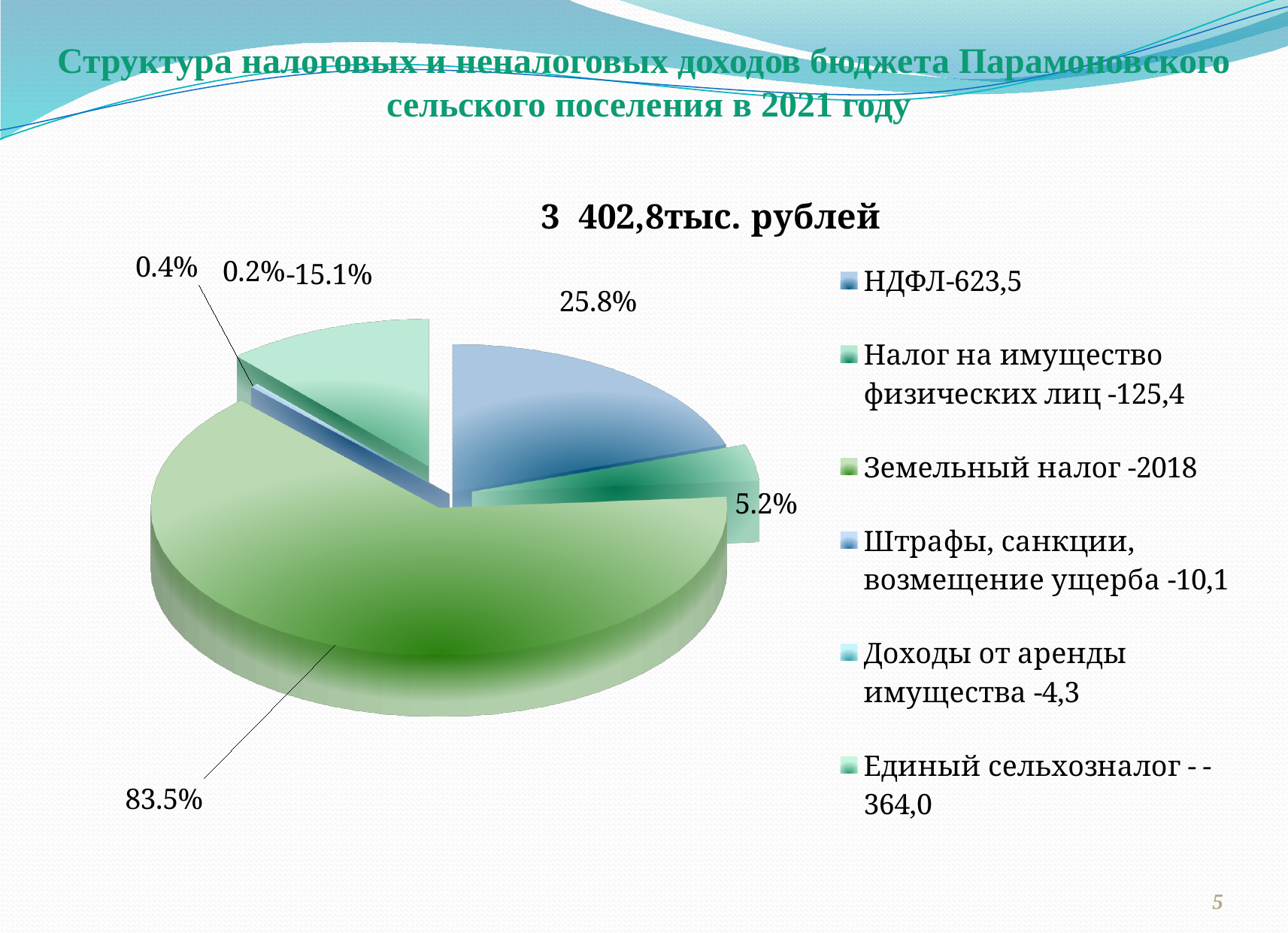
What kind of chart is shown on the slide? pie chart What percentage is shown for the Земельный налог slice? 83.5% Which slice is larger, НДФЛ or Налог на имущество физических лиц? НДФЛ How many categories does the legend of the pie chart list? 6 What percentage is shown for the Единый сельхозналог slice? -15.1% What is the difference in percentage points between the НДФЛ slice (25.8%) and the Налог на имущество физических лиц slice (5.2%)? 20.6% What percentage is shown for the НДФЛ slice? 25.8% What percentage is shown for the Налог на имущество физических лиц slice? 5.2% What is the title of the pie chart? 3 402,8тыс. рублей What value is given in the legend for Земельный налог? 2018 What value is given in the legend for Штрафы, санкции, возмещение ущерба? 10,1 Which category has the largest slice of the pie chart? Земельный налог